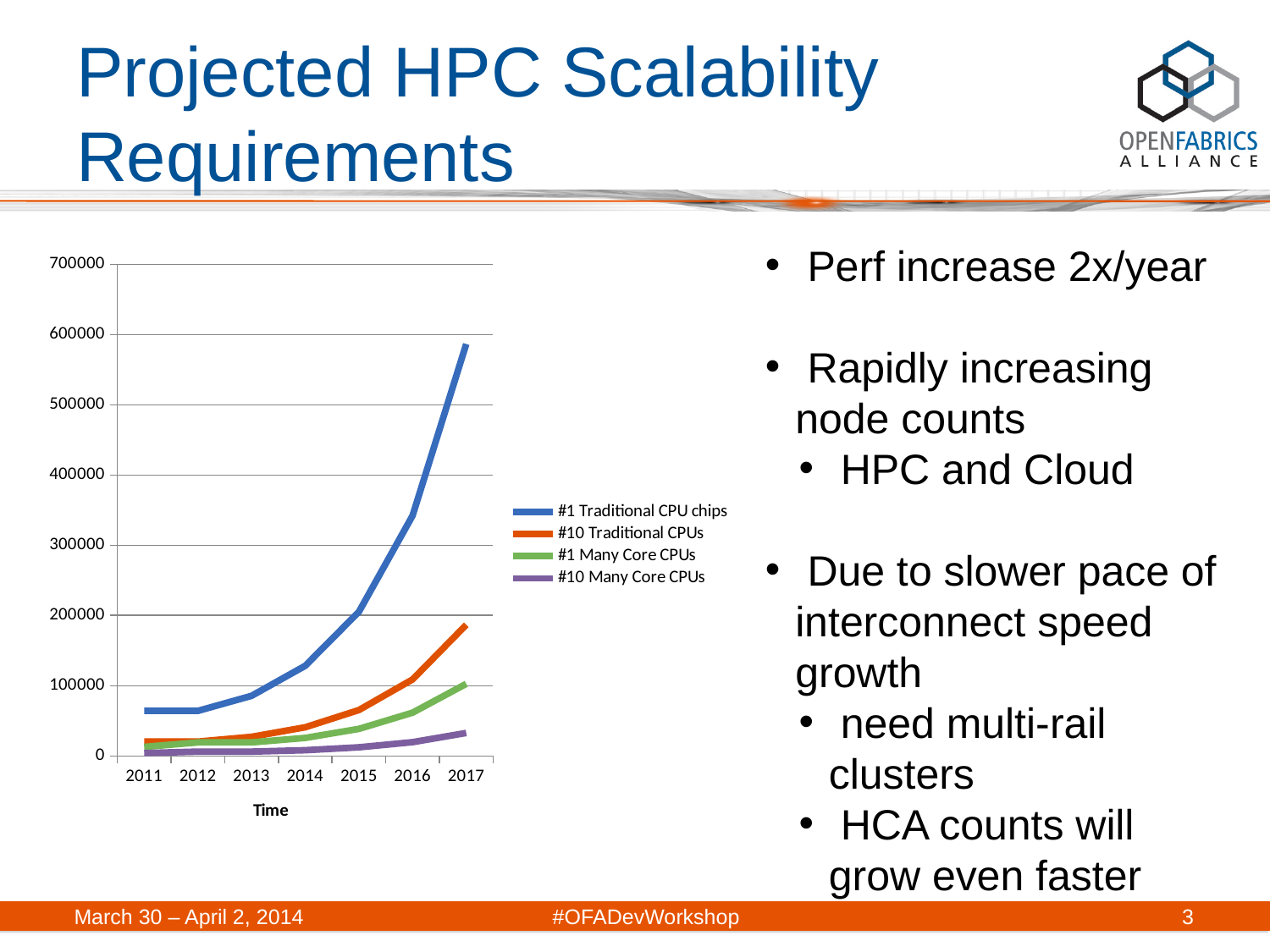
Which series has the lowest value in 2017? #10 Many Core CPUs Is the value for #1 Traditional CPU chips in 2017 greater or less than 500000? greater Is the value for #1 Traditional CPU chips in 2011 greater or less than 100000? less Which series is drawn in blue in the chart? #1 Traditional CPU chips What is the title of the x axis of the chart? Time Does the #1 Traditional CPU chips series rise or fall from 2011 to 2017? rise In 2017, which is larger: #10 Traditional CPUs or #1 Many Core CPUs? #10 Traditional CPUs Which series has the highest value in 2017? #1 Traditional CPU chips Is the value for #10 Many Core CPUs in 2017 greater or less than 100000? less What kind of chart is shown on the slide? line chart How many years are plotted along the x axis of the chart? 7 How many series does the chart's legend list? 4